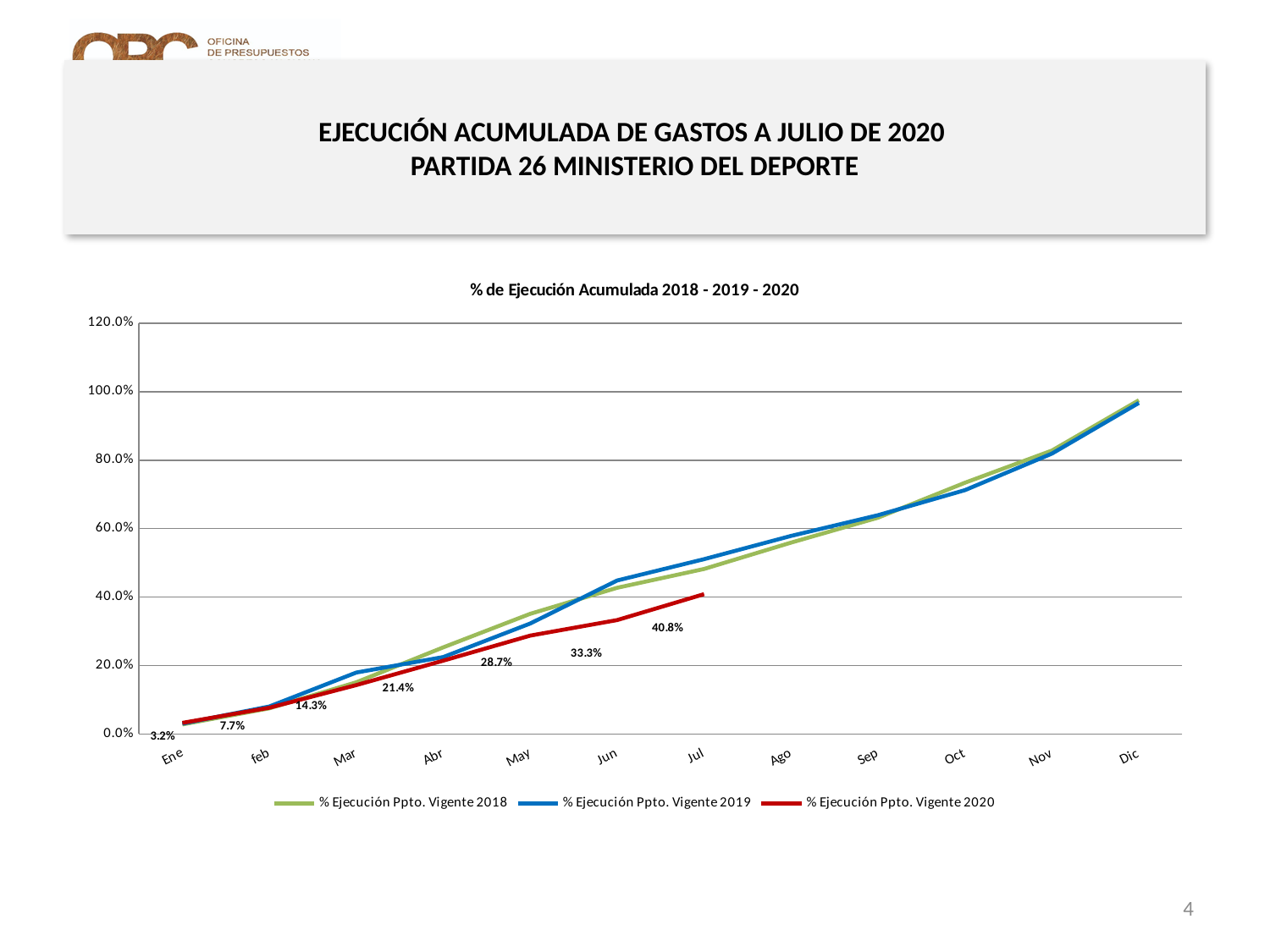
How many months are shown on the x axis? 12 Does the % Ejecución Ppto. Vigente 2020 series rise or fall from Ene to Jul? rise Is the value for % Ejecución Ppto. Vigente 2019 in Dic greater or less than 80.0%? greater What is the title of the chart? % de Ejecución Acumulada 2018 - 2019 - 2020 What is the value for % Ejecución Ppto. Vigente 2020 in Ene? 3.2% What is the value for % Ejecución Ppto. Vigente 2020 in Jul? 40.8% What is the value for % Ejecución Ppto. Vigente 2020 in Abr? 21.4% What is the value for % Ejecución Ppto. Vigente 2020 in May? 28.7% In which month is the % Ejecución Ppto. Vigente 2020 series highest? Jul How many series does the legend list? 3 What is the difference between the % Ejecución Ppto. Vigente 2020 values for Jul and Jun? 7.5% What type of chart is shown on the slide? line chart